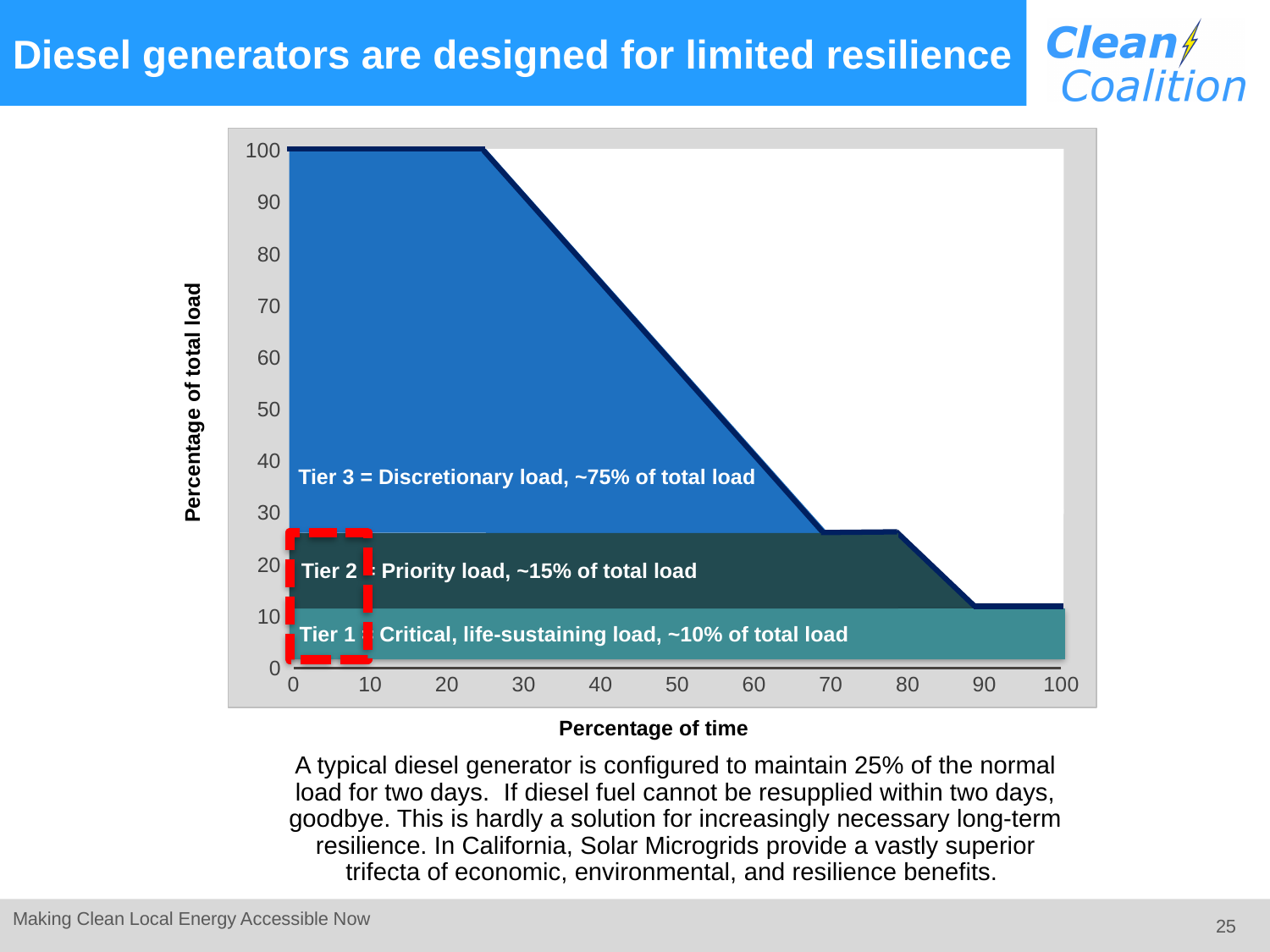
Is the percentage of total load at 75 percent of time greater or less than 40? less What is the title of the x axis of the chart? Percentage of time What is the percentage of total load at 0 percent of time? 100 Is the percentage of total load at 50 percent of time greater or less than 50? greater What is the title of the y axis of the chart? Percentage of total load What is the highest value shown on the y axis of the chart? 100 Do the values of percentage of total load rise or fall as percentage of time increases? fall What kind of chart is shown on the slide? area chart What is the percentage of total load at 20 percent of time? 100 Is the percentage of total load at 100 percent of time greater or less than 20? less Which is larger, the percentage of total load at 30 percent of time or at 90 percent of time? 30 percent of time